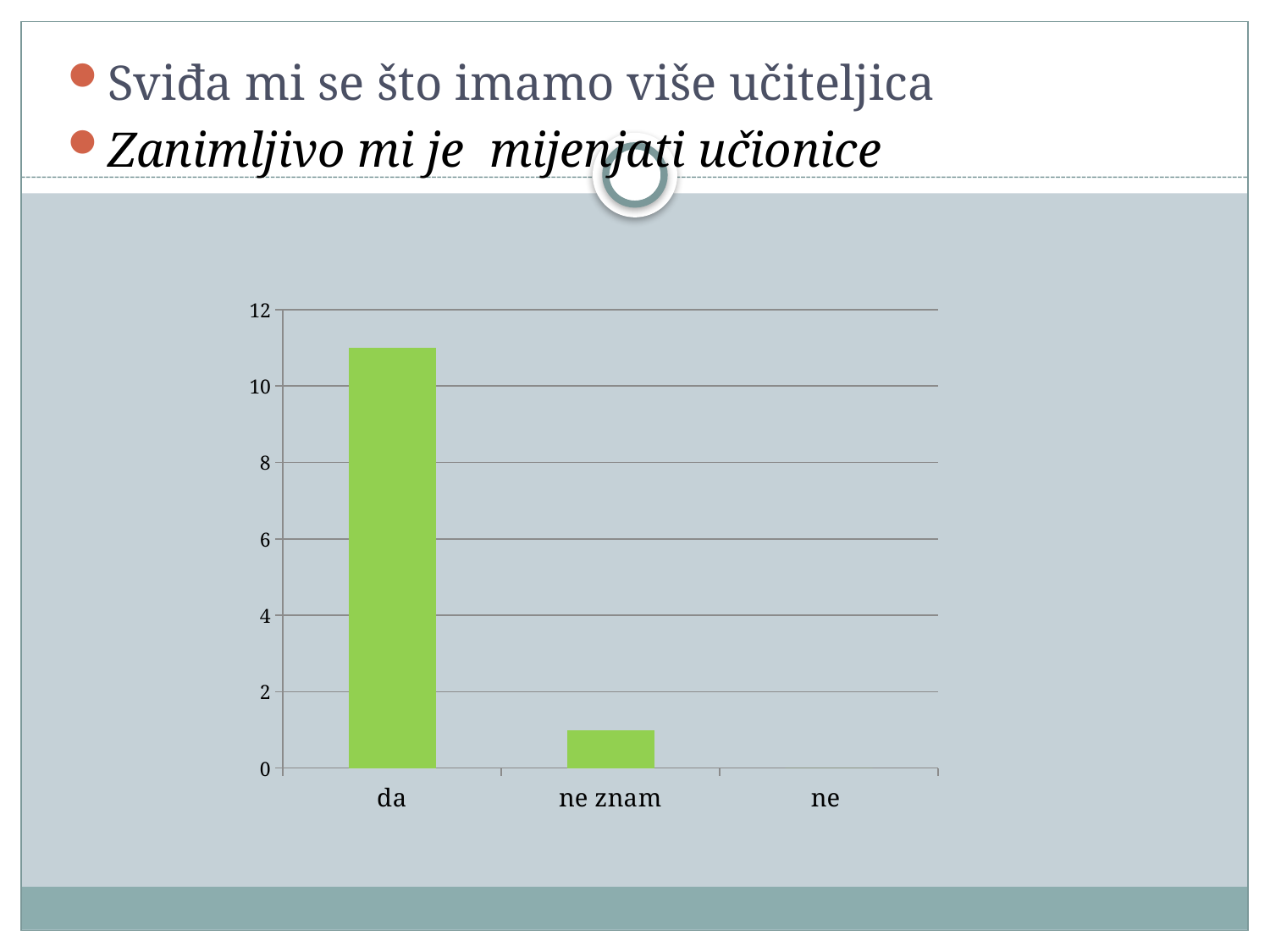
Which category has the lowest value in the chart? ne Do the values rise or fall from left to right along the x axis? fall Which is larger, the value for "da" or the value for "ne znam"? da What is the highest value shown on the vertical axis of the chart? 12 Is the value for "ne znam" greater or less than 2? less What kind of chart is shown on the slide? bar chart What is the value for "ne" in the chart? 0 Is the value for "da" greater or less than 10? greater Is the value for "da" greater or less than 12? less How many categories are shown on the x axis of the chart? 3 Which category has the highest value in the chart? da What colour are the bars in the chart? green